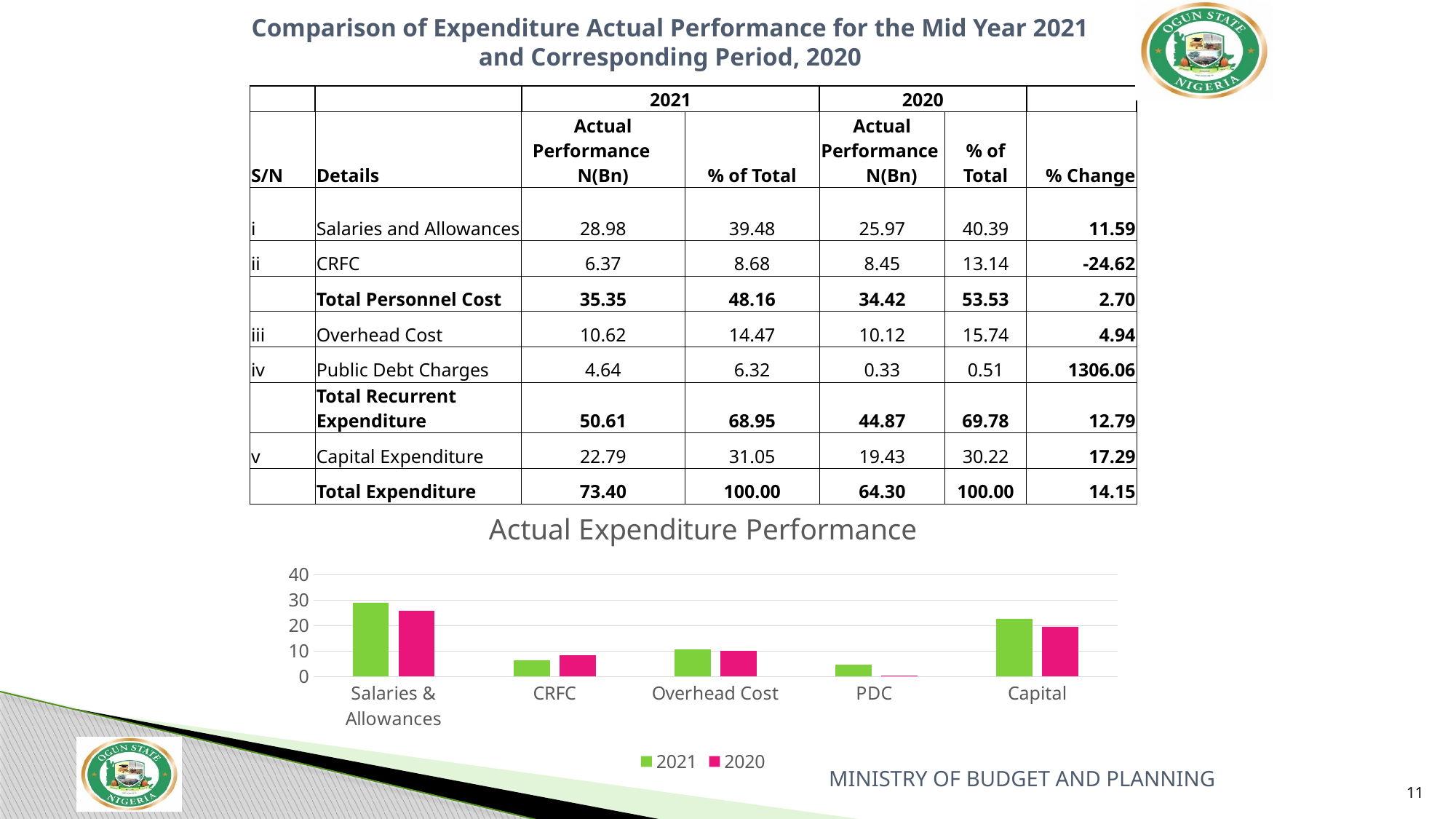
How many categories are shown on the x axis of the 'Actual Expenditure Performance' chart? 5 In the 'Actual Expenditure Performance' chart, is the 2020 value for PDC greater or less than 10? less What kind of chart is shown under the title 'Actual Expenditure Performance'? bar chart How many series does the legend of the 'Actual Expenditure Performance' chart list? 2 In the 'Actual Expenditure Performance' chart, is the 2021 or the 2020 bar larger for Salaries & Allowances? 2021 In the 'Actual Expenditure Performance' chart, which category has the lowest 2021 value? PDC In the 'Actual Expenditure Performance' chart, is the 2021 value for Salaries & Allowances greater or less than 20? greater In the 'Actual Expenditure Performance' chart, is the 2021 value for Capital greater or less than 10? greater In the 'Actual Expenditure Performance' chart, which category has the highest 2021 value? Salaries & Allowances In the 'Actual Expenditure Performance' chart, is the 2021 or the 2020 bar larger for CRFC? 2020 In the 'Actual Expenditure Performance' chart, which colour represents the 2021 series? green In the 'Actual Expenditure Performance' chart, which category has the lowest 2020 value? PDC